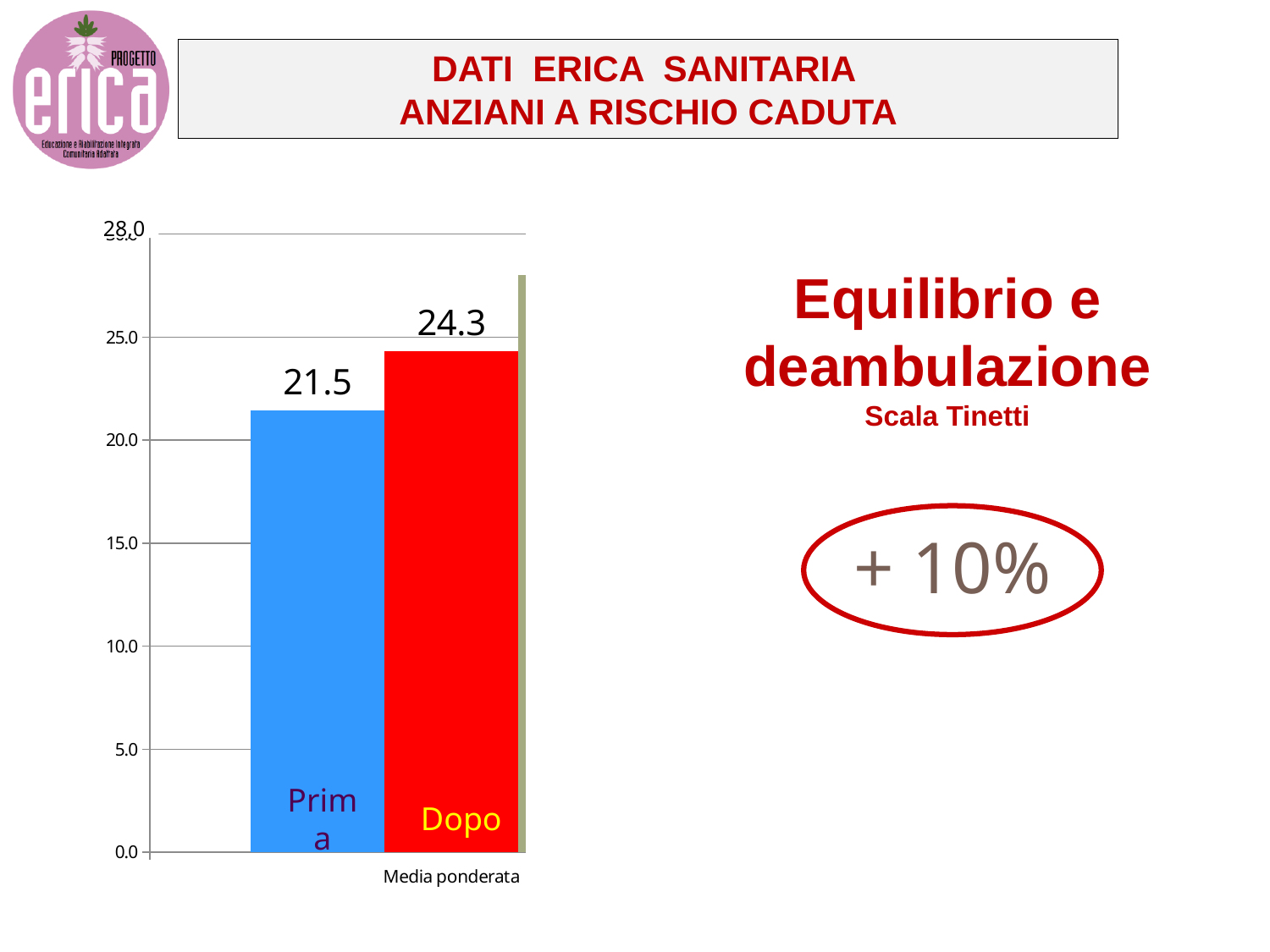
What is the value of the Dopo bar? 24.3 What label appears below the bars on the x axis? Media ponderata Which bar is lower, Prima or Dopo? Prima What is the value of the Prima bar? 21.5 What kind of chart is shown on the slide? bar chart Which bar is higher, Prima or Dopo? Dopo Is the value for Prima greater or less than 20.0? greater What is the difference between the Dopo and Prima values? 2.8 How many bars are plotted in the chart? 3 What colour is the Dopo bar? red Does the value rise or fall from Prima to Dopo? rise Is the value for Dopo greater or less than 25.0? less